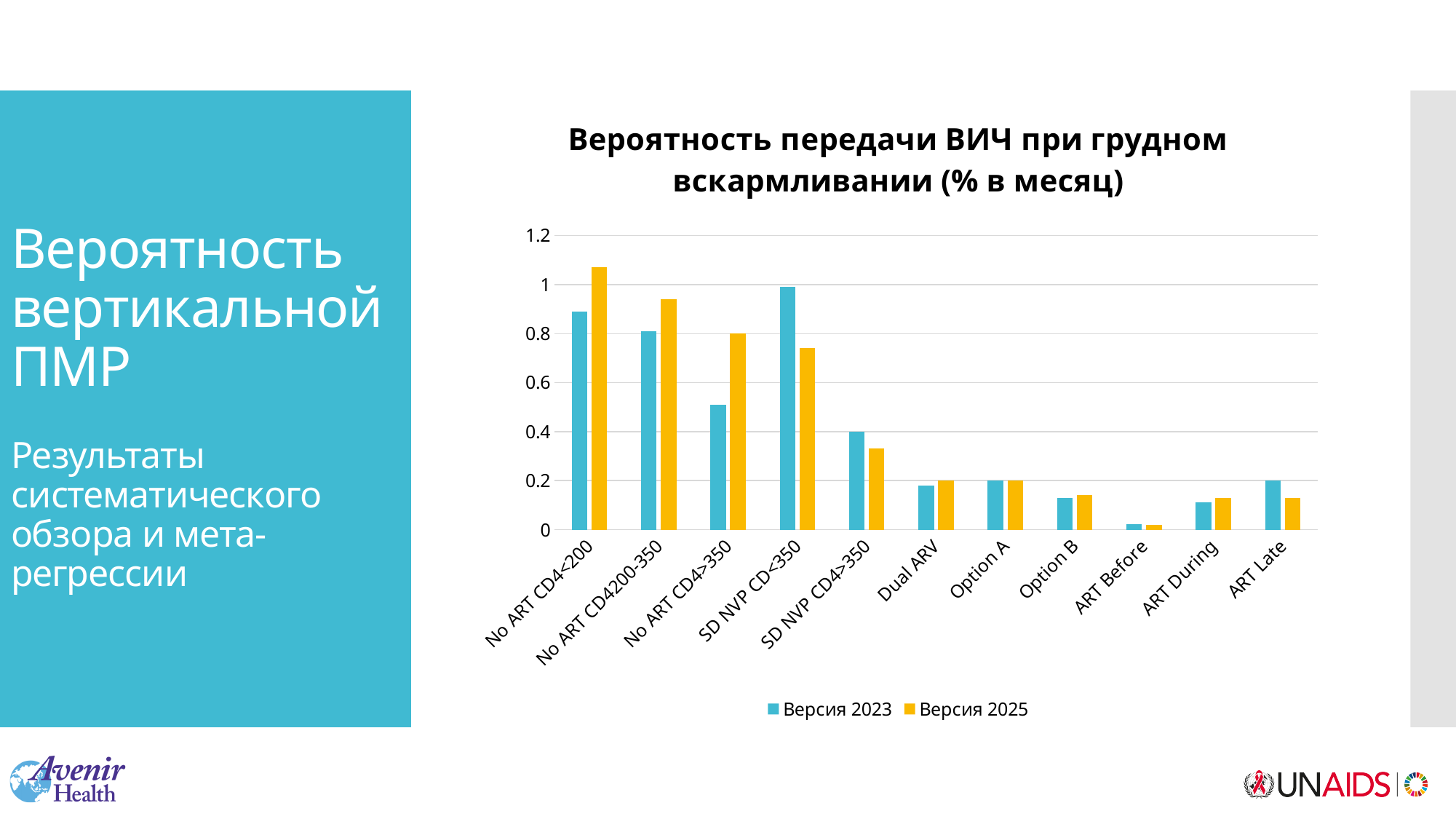
For No ART CD4<200, which series has the larger value, Версия 2023 or Версия 2025? Версия 2025 Which category has the highest bar in the chart? No ART CD4<200 How many categories are shown on the x axis of the chart? 11 What kind of chart is shown on the slide? bar chart Which category has the lowest bars in the chart? ART Before Is the Версия 2023 value for No ART CD4>350 greater or less than 0.4? greater For SD NVP CD<350, which series has the larger value, Версия 2023 or Версия 2025? Версия 2023 Is the Версия 2025 value for SD NVP CD4>350 greater or less than 0.4? less Is the Версия 2023 value for No ART CD4<200 greater or less than 0.8? greater How many series does the chart legend list? 2 What are the two series named in the chart legend? Версия 2023 and Версия 2025